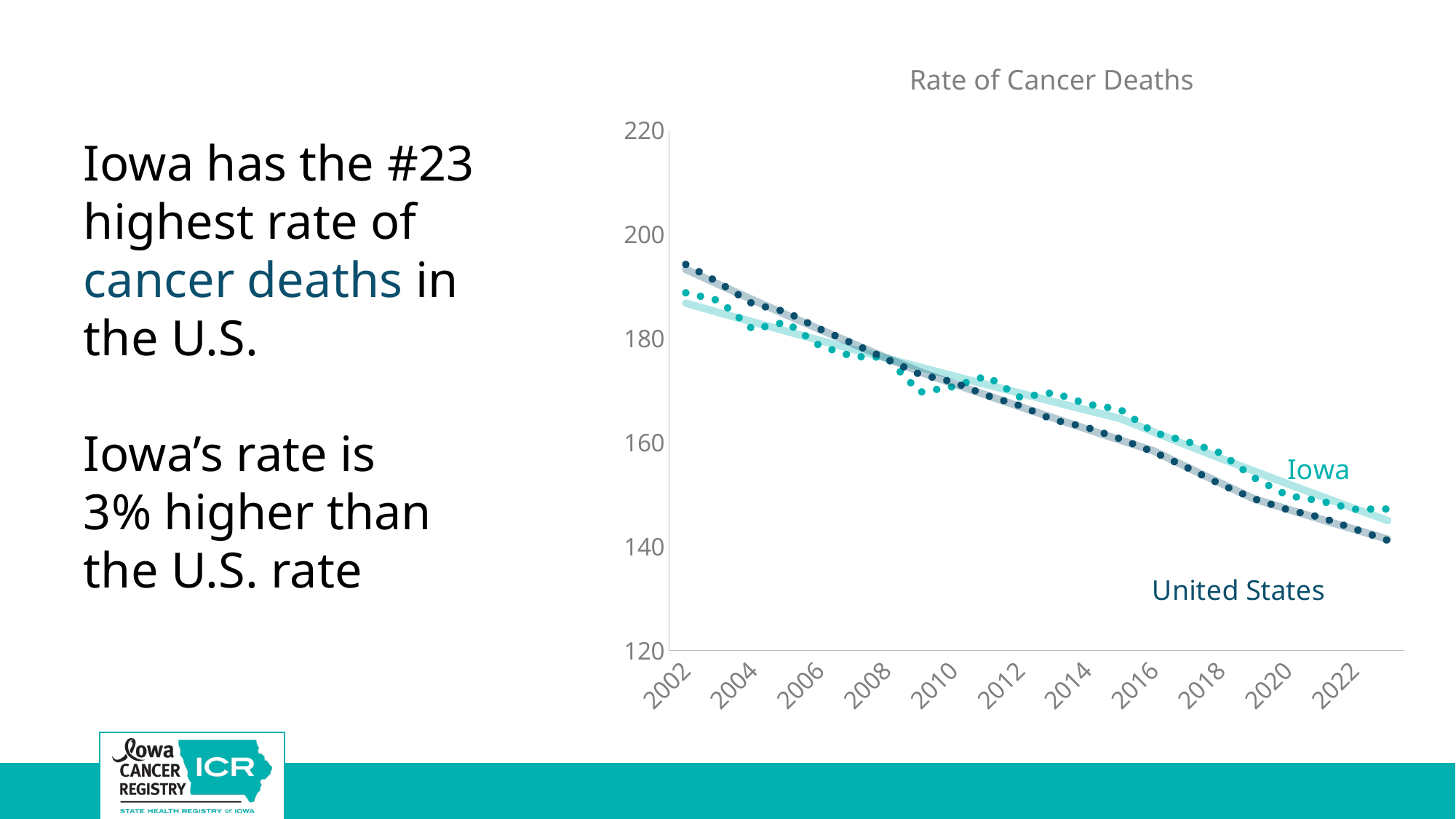
In 2002, which series has the higher rate of cancer deaths, Iowa or United States? United States Is the Iowa value in 2002 greater or less than 180? greater Is the Iowa value in 2014 greater or less than 160? greater In 2022, which series has the higher rate of cancer deaths, Iowa or United States? Iowa Is the United States value in 2002 greater or less than 180? greater What is the lowest value shown on the vertical axis? 120 What is the title of the chart? Rate of Cancer Deaths Which two series are labelled on the chart? Iowa and United States Do the cancer death rates rise or fall from 2002 to 2022? fall